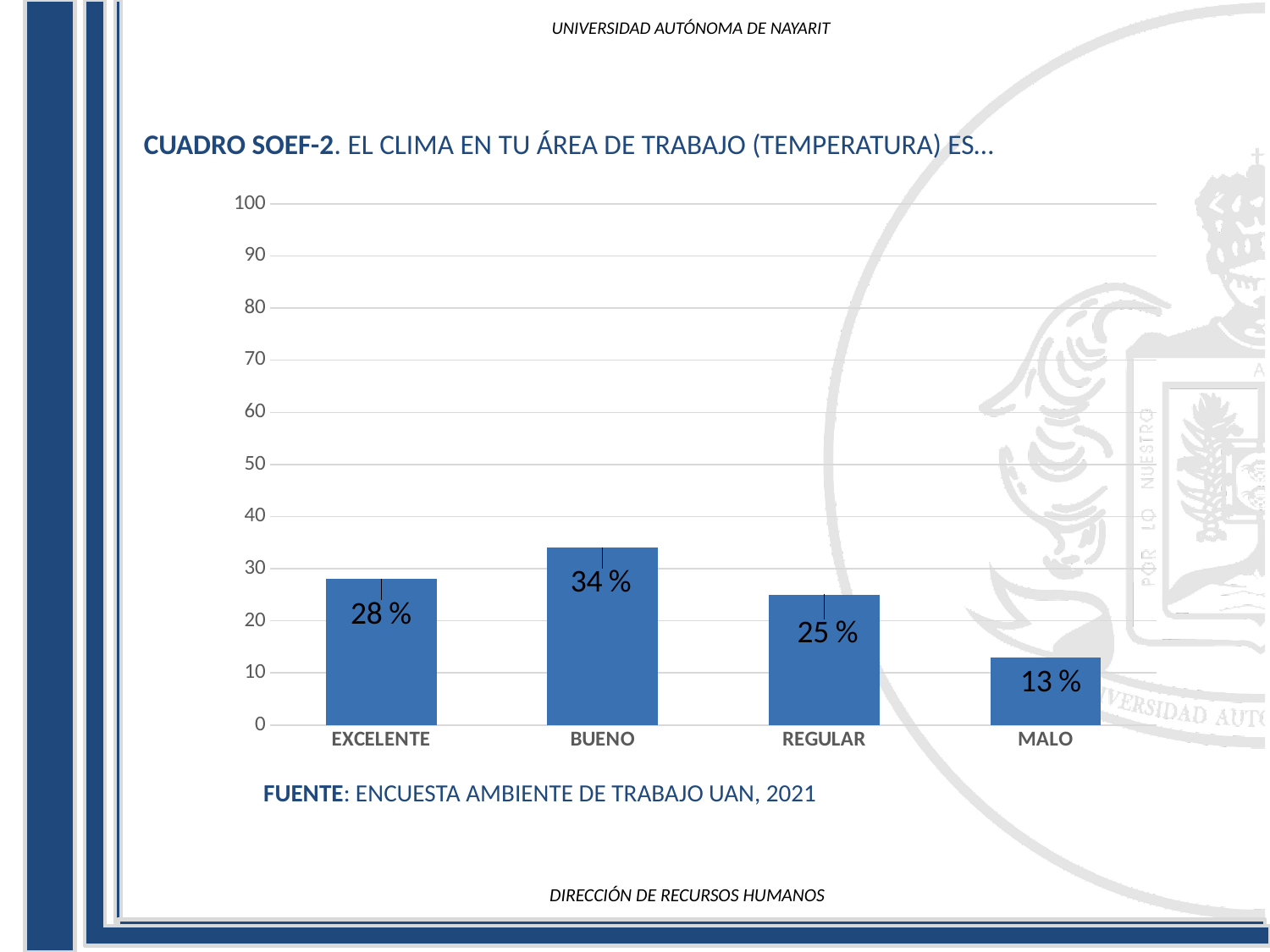
Which category has the highest value? BUENO Which is larger, the value for EXCELENTE or the value for MALO? EXCELENTE What kind of chart is shown on the slide? bar chart What is the value for REGULAR? 25 % What is the value for MALO? 13 % What is the value for BUENO? 34 % What is the value for EXCELENTE? 28 % What is the difference between the values for EXCELENTE and REGULAR? 3 % Which category has the lowest value? MALO How many categories are shown on the x axis? 4 Is the value for REGULAR greater or less than 30? less What is the difference between the values for BUENO and MALO? 21 %